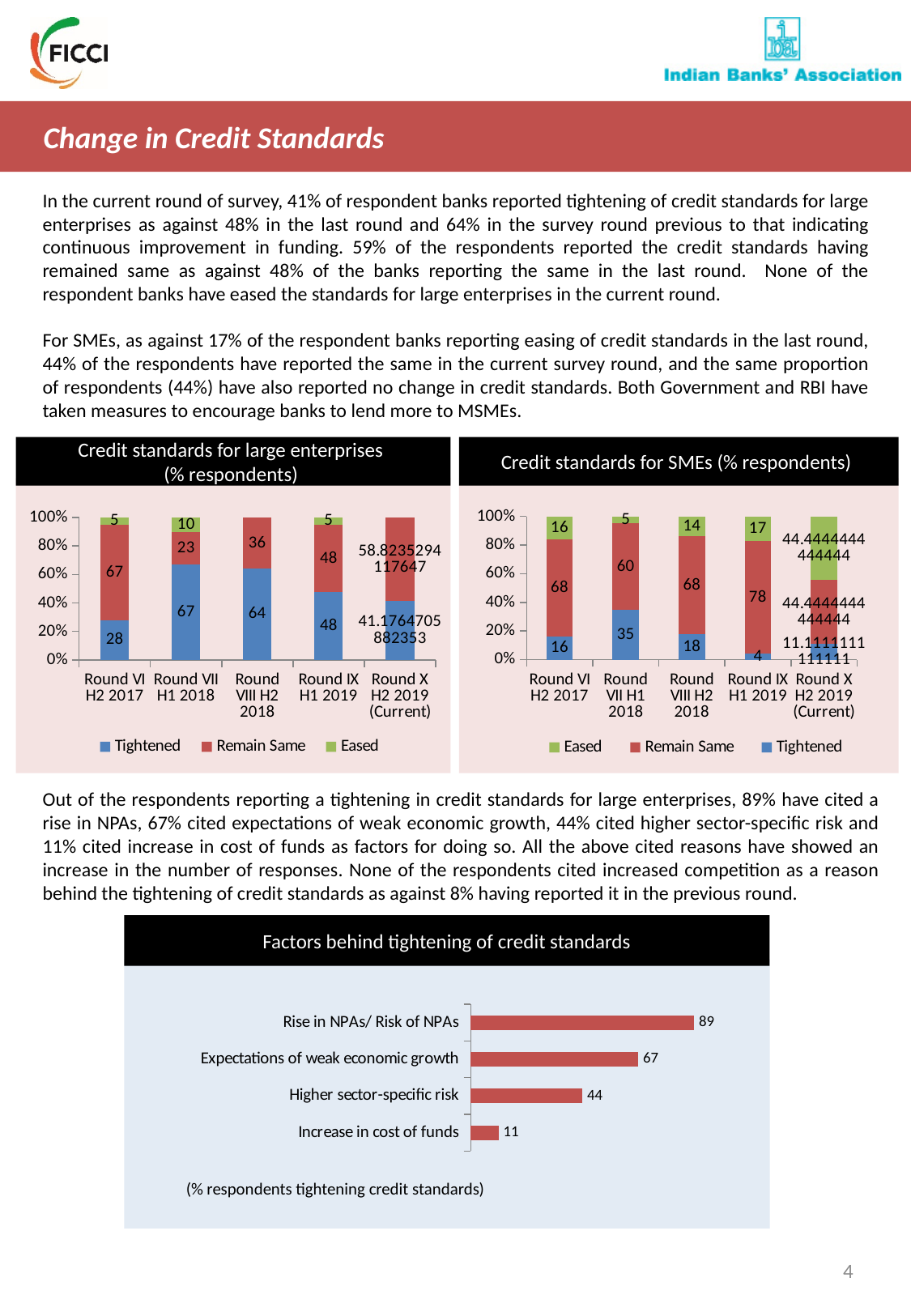
In the 'Credit standards for SMEs' chart, how many rounds are shown on the x axis? 5 In the 'Credit standards for SMEs' chart, what is the Remain Same value for Round IX H1 2019? 78 In the 'Credit standards for large enterprises' chart, how many series does the legend list? 3 In the 'Factors behind tightening of credit standards' chart, what is the value for Higher sector-specific risk? 44 In the 'Credit standards for large enterprises' chart, what is the Tightened value for Round VII H1 2018? 67 What kind of chart is the 'Factors behind tightening of credit standards' chart? Bar chart In the 'Credit standards for SMEs' chart, which round has the highest Tightened value? Round VII H1 2018 In the 'Credit standards for SMEs' chart, which round has the lowest Tightened value? Round IX H1 2019 In the 'Factors behind tightening of credit standards' chart, what is the difference between Expectations of weak economic growth and Increase in cost of funds? 56 In the 'Credit standards for large enterprises' chart, what is the difference between the Remain Same and Tightened values for Round VI H2 2017? 39 In the 'Factors behind tightening of credit standards' chart, which factor has the highest value? Rise in NPAs/ Risk of NPAs In the 'Credit standards for large enterprises' chart, what is the Remain Same value for Round VIII H2 2018? 36